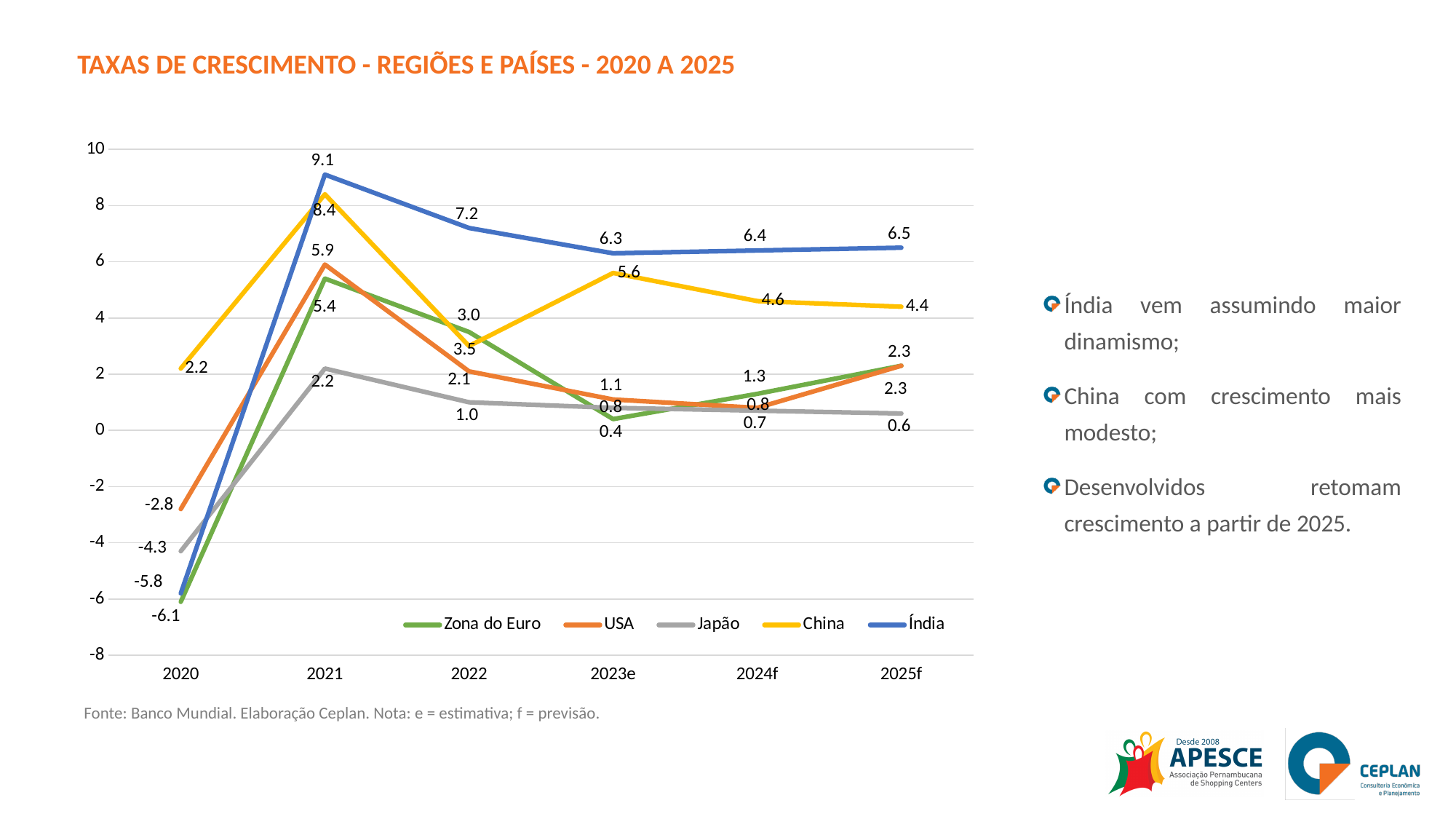
What is the growth rate for Índia in 2021? 9.1 What is the growth rate for China in 2020? 2.2 Which series has the highest value in 2021? Índia What is the growth rate for Zona do Euro in 2020? -6.1 What type of chart is shown on the slide? line chart Does the Índia line rise or fall from 2021 to 2023e? fall How many series does the legend list? 5 How many years (points) are shown on the x axis? 6 What is the difference between Índia's and China's growth rates in 2025f? 2.1 What is the growth rate for Japão in 2025f? 0.6 Which is larger in 2023e, the value for China or the value for Índia? Índia Which series has the lowest value in 2020? Zona do Euro